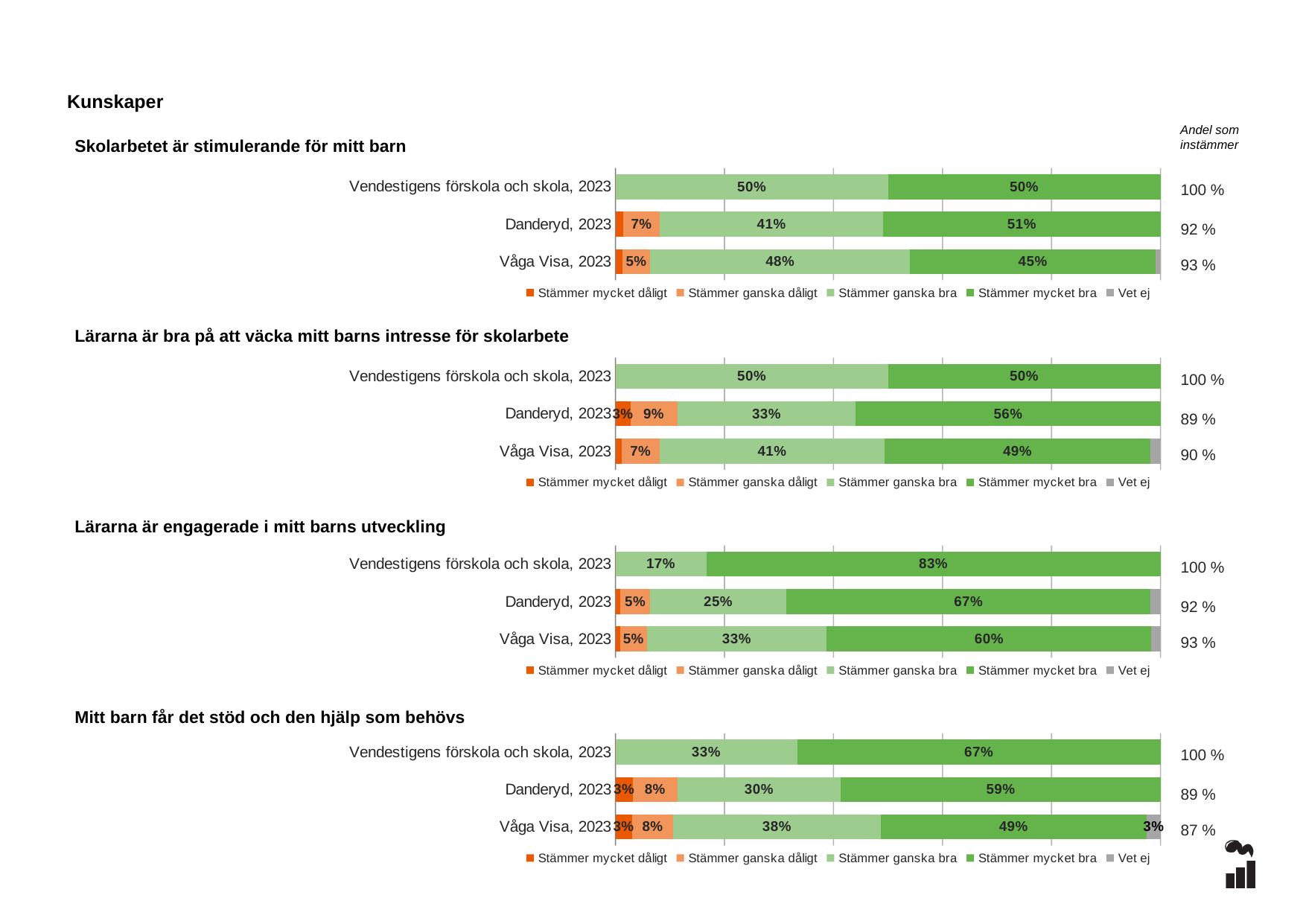
In the chart 'Skolarbetet är stimulerande för mitt barn', what is the 'Stämmer ganska bra' value for Våga Visa, 2023? 48% In the chart 'Lärarna är engagerade i mitt barns utveckling', what is the 'Stämmer mycket bra' value for Vendestigens förskola och skola, 2023? 83% In the chart 'Lärarna är engagerade i mitt barns utveckling', which row has the highest 'Stämmer mycket bra' value? Vendestigens förskola och skola, 2023 In the chart 'Lärarna är bra på att väcka mitt barns intresse för skolarbete', what is the difference between the 'Stämmer mycket bra' values for Danderyd, 2023 and Våga Visa, 2023? 7% In the chart 'Skolarbetet är stimulerande för mitt barn', which is larger: the 'Stämmer mycket bra' value for Danderyd, 2023 or for Våga Visa, 2023? Danderyd, 2023 In the chart 'Mitt barn får det stöd och den hjälp som behövs', what is the 'Stämmer ganska dåligt' value for Danderyd, 2023? 8% What type of chart is 'Skolarbetet är stimulerande för mitt barn'? Stacked bar chart In the chart 'Mitt barn får det stöd och den hjälp som behövs', what is the 'Vet ej' value for Våga Visa, 2023? 3% How many series does the legend list for the chart 'Mitt barn får det stöd och den hjälp som behövs'? 5 In the chart 'Lärarna är bra på att väcka mitt barns intresse för skolarbete', what is the 'Andel som instämmer' value for Danderyd, 2023? 89 % In the chart 'Mitt barn får det stöd och den hjälp som behövs', which row has the lowest 'Andel som instämmer' value? Våga Visa, 2023 How many rows (bars) are shown in the chart 'Lärarna är engagerade i mitt barns utveckling'? 3